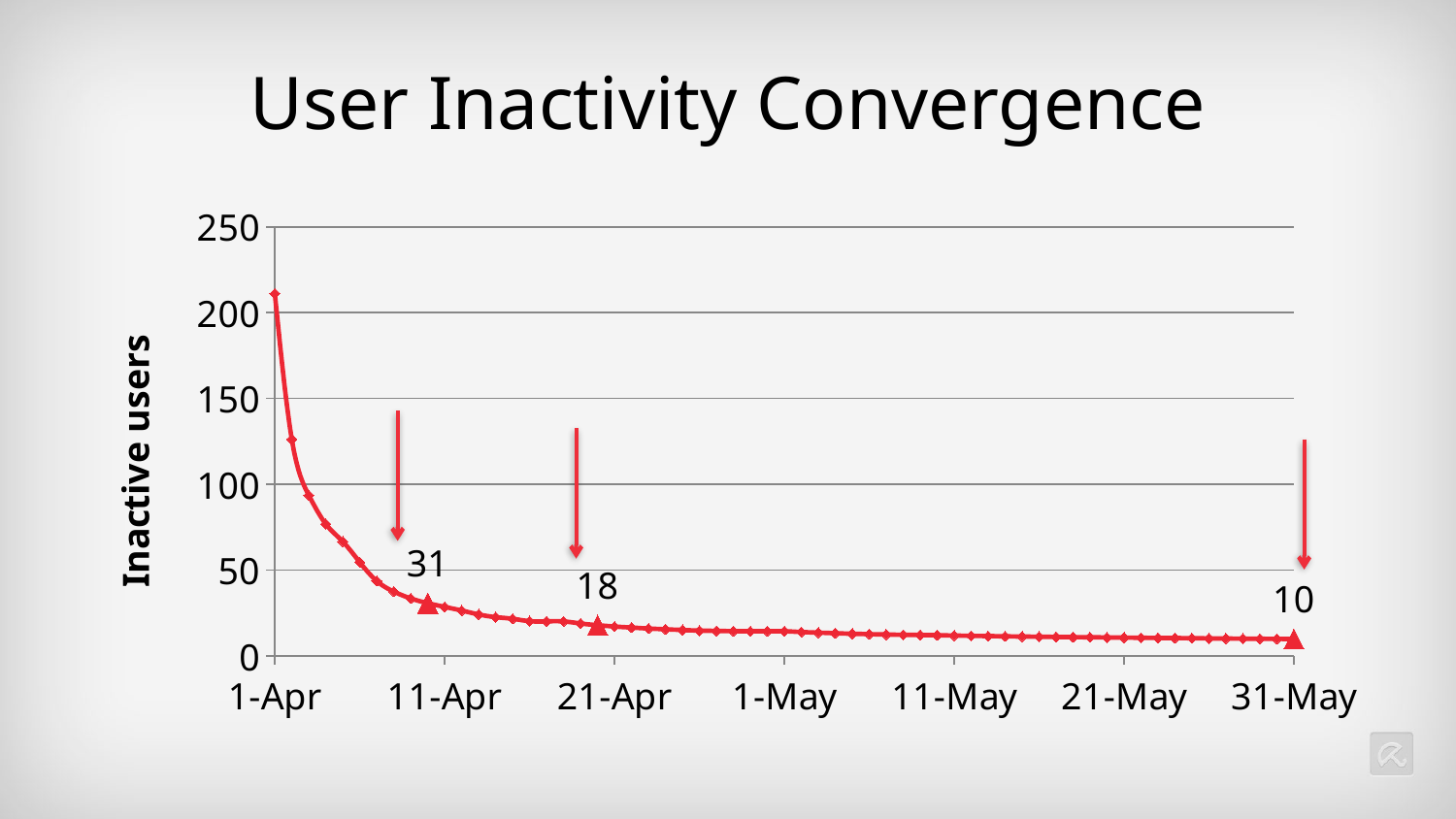
What kind of chart is shown on the slide? line chart What is the labeled value of inactive users on 31-May? 10 How many data points on the line are marked with a triangle and a printed value? 3 What is the label on the vertical axis? Inactive users What is the title of the chart? User Inactivity Convergence What is the second labeled value on the line, marked with a triangle near 21-Apr? 18 Do the values rise or fall from 1-Apr to 31-May? fall What is the difference between the first labeled value (31) and the second labeled value (18)? 13 What is the first labeled value on the line, marked with a triangle near 11-Apr? 31 Is the value for 1-May greater or less than 50? less What is the difference between the first labeled value (31) and the value on 31-May (10)? 21 Is the value for 1-Apr greater or less than 200? greater